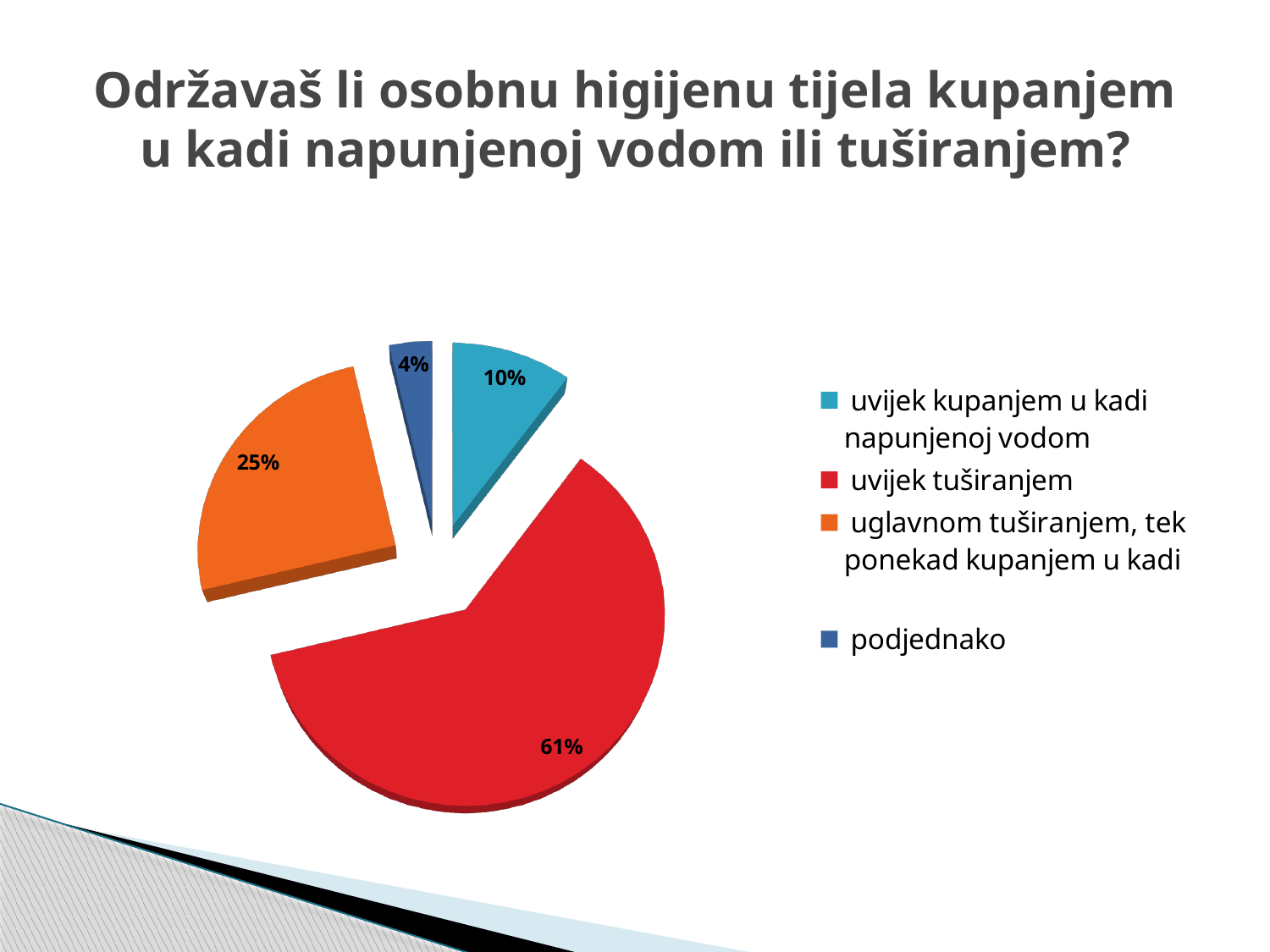
What colour is the slice for "uglavnom tuširanjem, tek ponekad kupanjem u kadi"? orange What percentage of respondents answered "uglavnom tuširanjem, tek ponekad kupanjem u kadi"? 25% What percentage of respondents answered "uvijek tuširanjem"? 61% What percentage of respondents answered "uvijek kupanjem u kadi napunjenoj vodom"? 10% What percentage of respondents answered "podjednako"? 4% What kind of chart is shown on the slide? pie chart Which category has the smallest share of the pie? podjednako Which category has the largest share of the pie? uvijek tuširanjem What is the title of the slide? Održavaš li osobnu higijenu tijela kupanjem u kadi napunjenoj vodom ili tuširanjem? What is the difference in percentage points between "uvijek tuširanjem" and "uglavnom tuširanjem, tek ponekad kupanjem u kadi"? 36 How many categories does the pie chart have? 4 Which is larger: the share for "uvijek kupanjem u kadi napunjenoj vodom" or the share for "podjednako"? uvijek kupanjem u kadi napunjenoj vodom